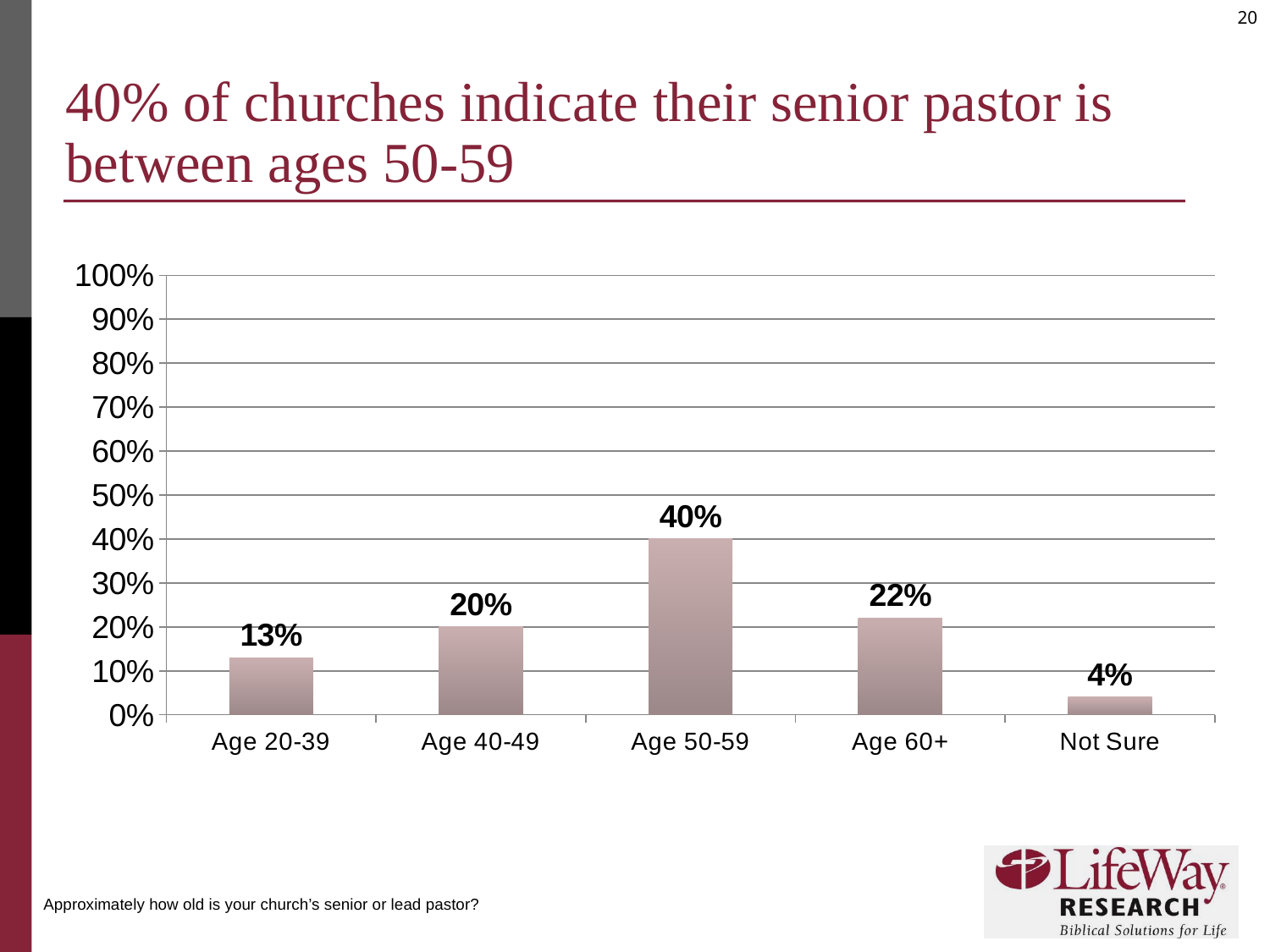
Which age category has the highest value? Age 50-59 What kind of chart is shown on the slide? bar chart What is the difference between the values for Age 50-59 and Age 60+? 18% How many categories are shown on the x axis? 5 What percentage of churches indicate their senior pastor is Age 50-59? 40% Is the value for Age 60+ greater or less than 30%? less What is the value for Age 20-39? 13% Which is larger, the value for Age 60+ or the value for Age 40-49? Age 60+ What is the highest value shown on the y axis? 100% What is the difference between the values for Age 40-49 and Age 20-39? 7% Which category has the lowest value? Not Sure What is the value for Not Sure? 4%